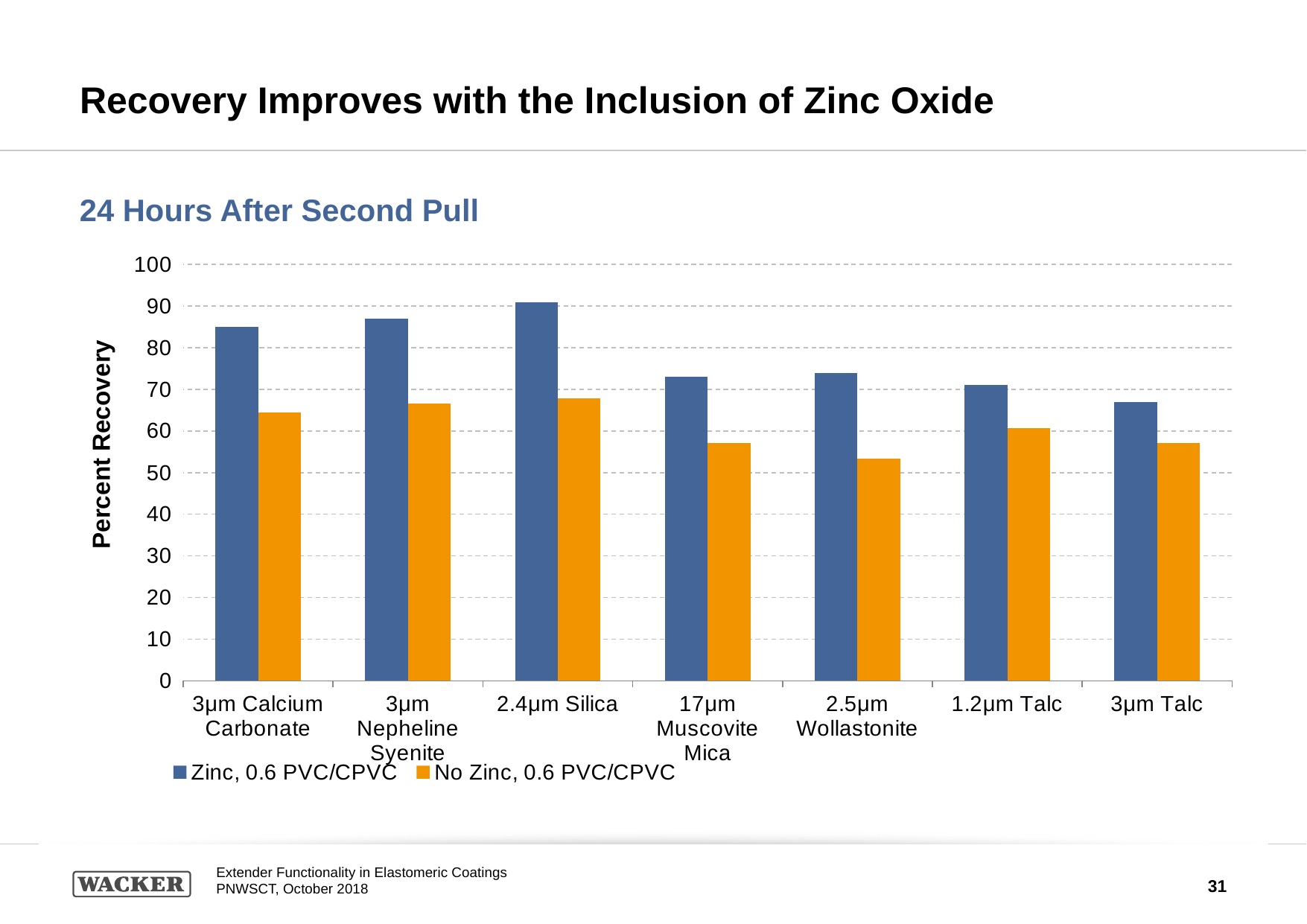
For 17µm Muscovite Mica, which series has the larger value: Zinc, 0.6 PVC/CPVC or No Zinc, 0.6 PVC/CPVC? Zinc, 0.6 PVC/CPVC For the No Zinc, 0.6 PVC/CPVC series, which is larger: 1.2µm Talc or 3µm Talc? 1.2µm Talc Is the No Zinc, 0.6 PVC/CPVC value for 3µm Calcium Carbonate greater or less than 60? greater Which category has the lowest value for the No Zinc, 0.6 PVC/CPVC series? 2.5µm Wollastonite How many extender categories are shown on the x axis? 7 Is the Zinc, 0.6 PVC/CPVC value for 2.4µm Silica greater or less than 80? greater How many series does the legend list? 2 What kind of chart is shown on the slide? Bar chart Which category has the highest value for the Zinc, 0.6 PVC/CPVC series? 2.4µm Silica What is the label on the vertical axis of the chart? Percent Recovery Which category has the lowest value for the Zinc, 0.6 PVC/CPVC series? 3µm Talc Is the No Zinc, 0.6 PVC/CPVC value for 2.5µm Wollastonite greater or less than 60? less